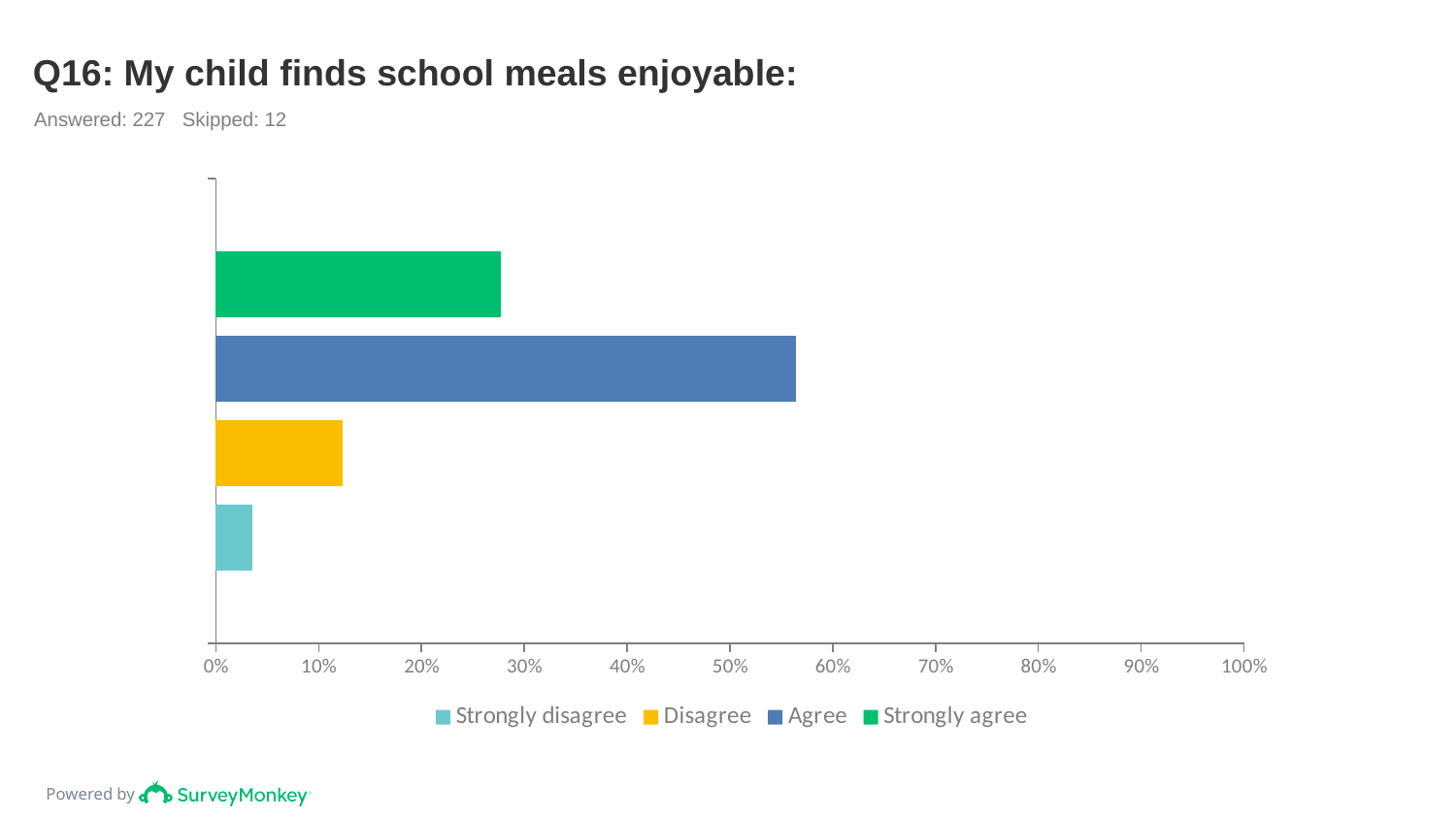
Is the value for Agree greater or less than 50%? greater Which response option has the lowest value? Strongly disagree Which is larger, the value for Agree or the value for Strongly agree? Agree Which response option has the highest value? Agree What kind of chart is shown on the slide? bar chart How many respondents answered the question according to the slide? 227 How many entries does the legend list? 4 What is the title of the chart? Q16: My child finds school meals enjoyable: Which is larger, the value for Strongly agree or the value for Disagree? Strongly agree How many bars are plotted in the chart? 4 Is the value for Strongly disagree greater or less than 10%? less Is the value for Strongly agree greater or less than 30%? less